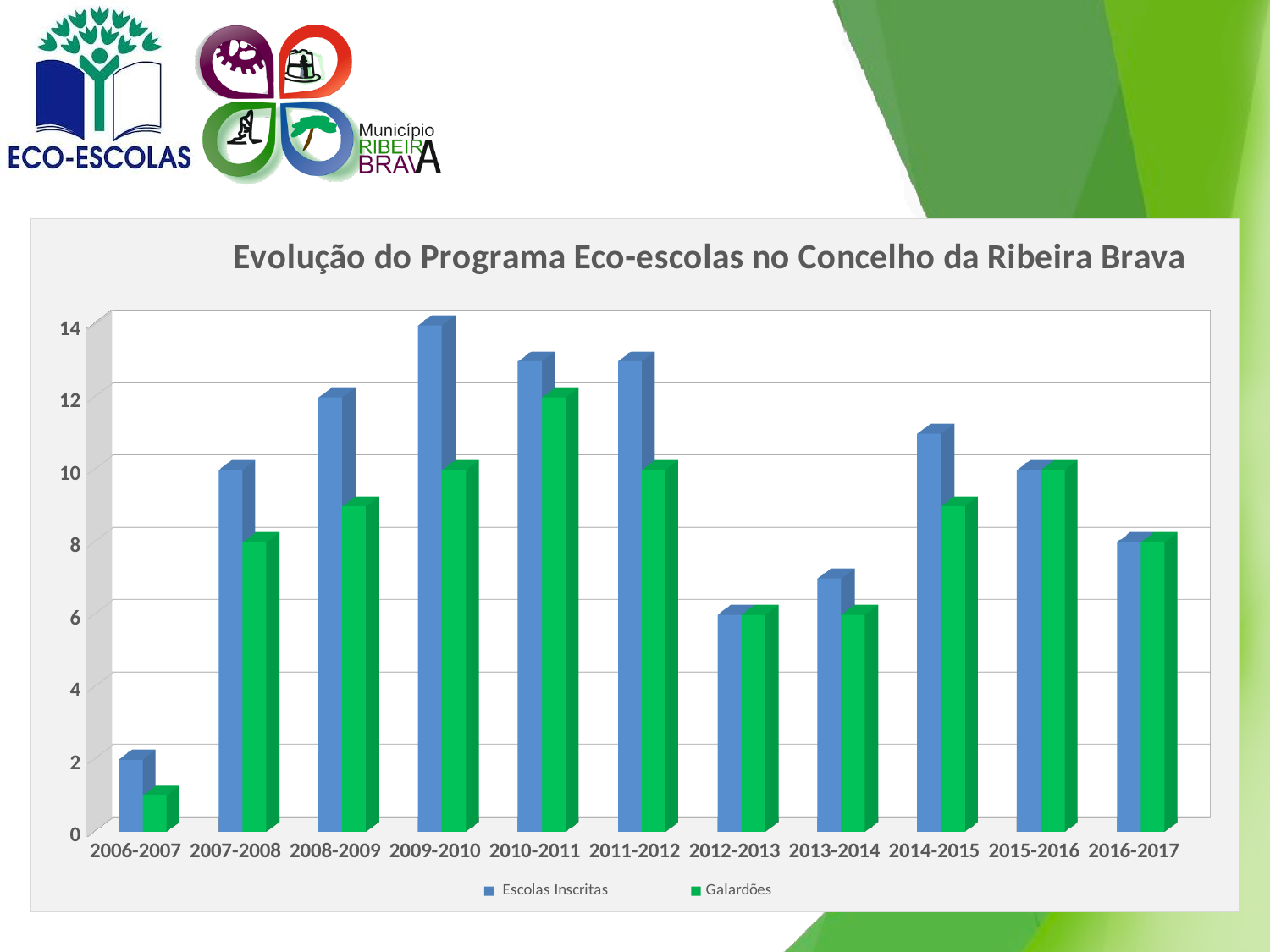
What is the value for Escolas Inscritas in 2009-2010? 14 How many series does the legend list? 2 In 2009-2010, which is larger: Escolas Inscritas or Galardões? Escolas Inscritas Is the value for Escolas Inscritas in 2013-2014 greater or less than 8? less In which school year is the value for Escolas Inscritas highest? 2009-2010 In which school year is the value for Galardões highest? 2010-2011 What type of chart is shown on the slide? Bar chart What is the title of the chart? Evolução do Programa Eco-escolas no Concelho da Ribeira Brava What is the value for Galardões in 2010-2011? 12 Is the value for Escolas Inscritas in 2014-2015 greater or less than 10? greater How many school-year categories are shown on the x axis? 11 In which school year is the value for Escolas Inscritas lowest? 2006-2007